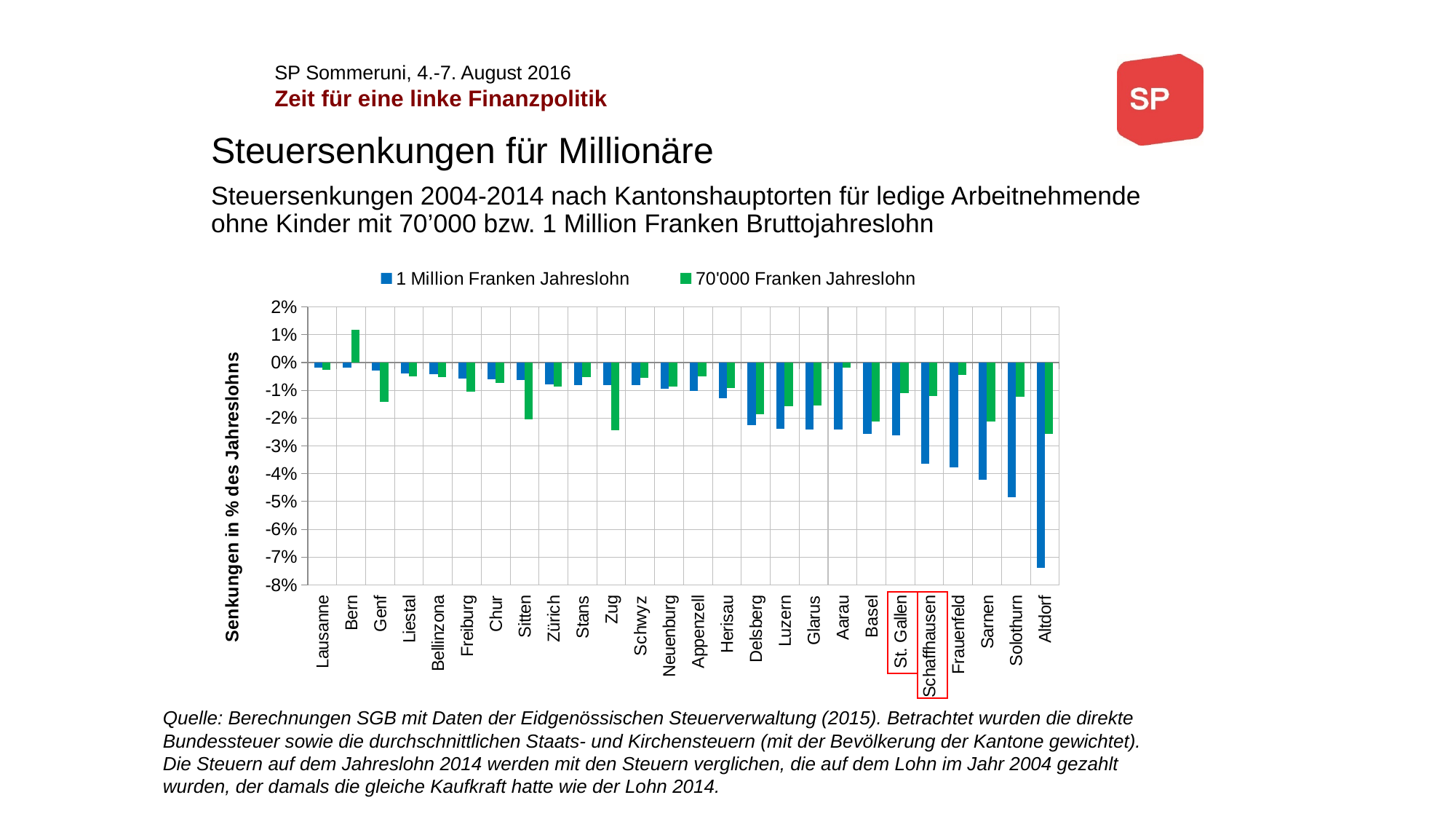
Is the value for Altdorf in the '1 Million Franken Jahreslohn' series greater or less than -7%? less Which is larger for the '1 Million Franken Jahreslohn' series, Solothurn or Altdorf? Solothurn Which category has the highest value for the '70'000 Franken Jahreslohn' series? Bern Is the value for Frauenfeld in the '1 Million Franken Jahreslohn' series greater or less than -3%? less How many cantonal capitals (categories) are shown on the x axis? 26 Is the value for Solothurn in the '1 Million Franken Jahreslohn' series greater or less than -4%? less What is the title of the vertical axis? Senkungen in % des Jahreslohns Do the values of the '1 Million Franken Jahreslohn' series generally rise or fall from left to right along the x axis? fall How many series does the legend list? 2 Which category has the lowest value for the '1 Million Franken Jahreslohn' series? Altdorf What kind of chart is shown on the slide? bar chart